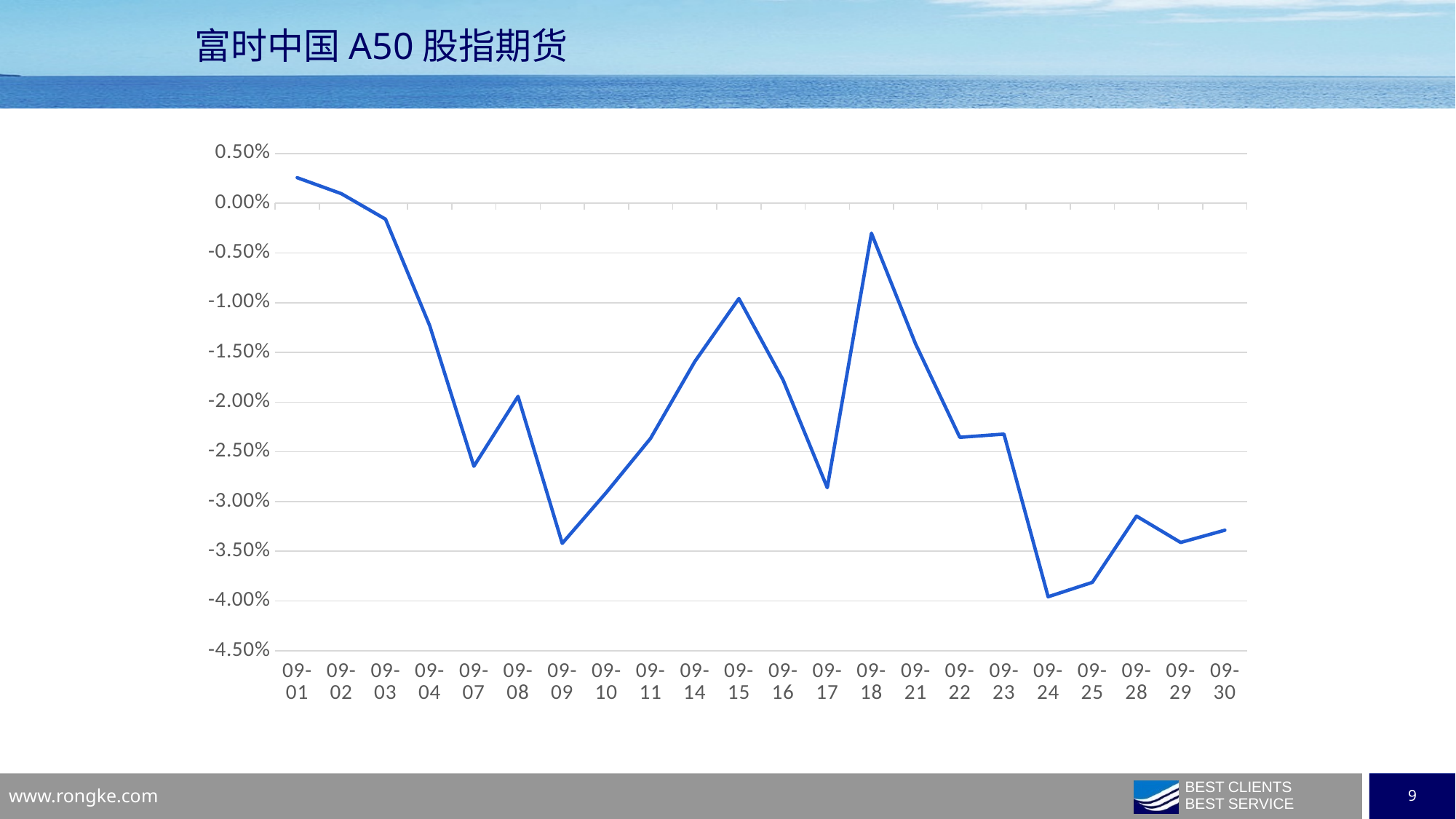
On which date is the plotted value lowest? 09-24 On which date is the plotted value highest? 09-01 What kind of chart is shown on the slide? line chart Is the value for 09-01 greater or less than 0.00%? greater Is the value for 09-18 greater or less than -0.50%? greater Which date has the larger value, 09-08 or 09-09? 09-08 Is the value for 09-09 greater or less than -3.00%? less What is the title of the chart? 富时中国 A50 股指期货 How many dates are plotted along the x axis? 22 Does the line rise or fall from 09-01 to 09-09? fall Which date has the larger value, 09-15 or 09-18? 09-18